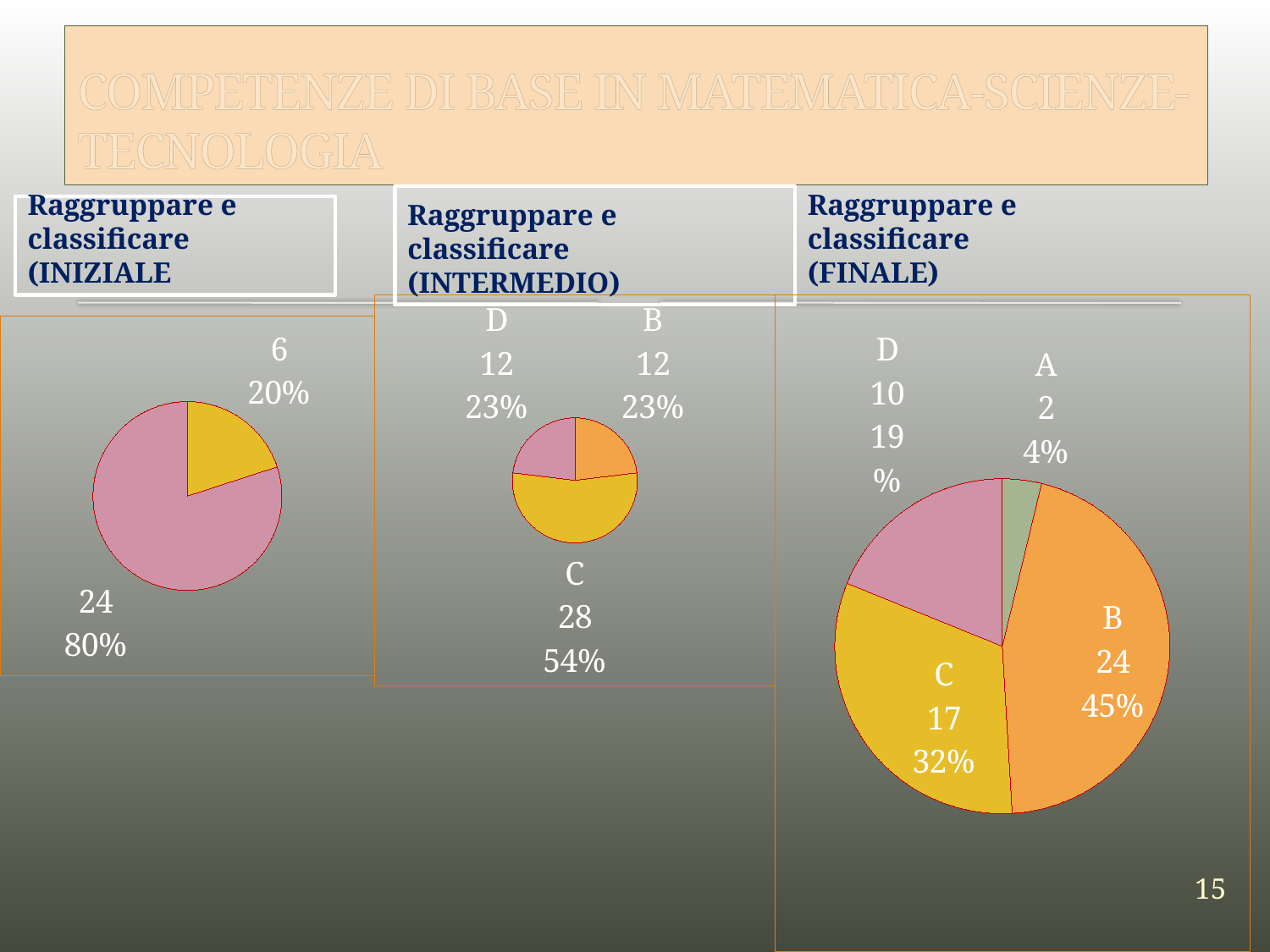
In the 'Raggruppare e classificare (INTERMEDIO)' chart, what share of the pie does category D have? 23% In the 'Raggruppare e classificare (FINALE)' chart, what is the difference between the values for B and C? 7 In the 'Raggruppare e classificare (FINALE)' chart, which category has the largest slice? B In the 'Raggruppare e classificare (FINALE)' chart, what share of the pie does category C have? 32% In the 'Raggruppare e classificare (FINALE)' chart, what is the value for category B? 24 What kind of chart is used in the 'Raggruppare e classificare (FINALE)' chart? pie chart In the 'Raggruppare e classificare (INTERMEDIO)' chart, which category has the largest slice? C In the 'Raggruppare e classificare (FINALE)' chart, which category has the smallest slice? A In the 'Raggruppare e classificare (INTERMEDIO)' chart, what is the value for category C? 28 In the 'Raggruppare e classificare (INIZIALE)' chart, what share of the pie does the larger slice have? 80% How many slices does the 'Raggruppare e classificare (INIZIALE)' pie chart have? 2 How many slices does the 'Raggruppare e classificare (FINALE)' pie chart have? 4